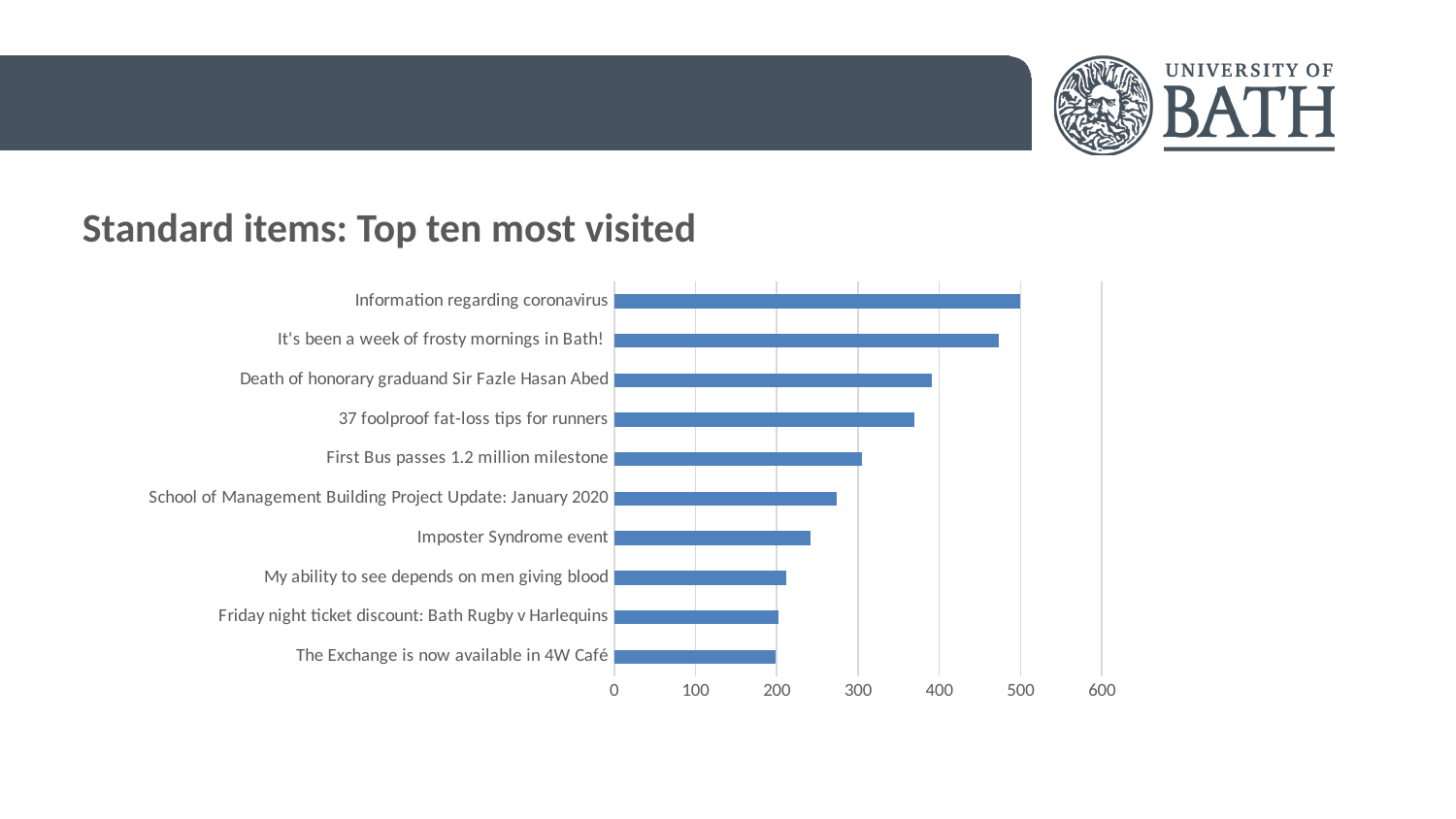
Which item has the highest value in the chart? Information regarding coronavirus Is the value for "37 foolproof fat-loss tips for runners" greater or less than 400? less What is the title of the slide above the chart? Standard items: Top ten most visited Is the value for "My ability to see depends on men giving blood" greater or less than 300? less Is the value for "Death of honorary graduand Sir Fazle Hasan Abed" greater or less than 300? greater Do the bar values increase or decrease going from the top item to the bottom item? decrease What kind of chart is shown on the slide? bar chart How many items are plotted in the chart? 10 Which has the larger value: "First Bus passes 1.2 million milestone" or "Imposter Syndrome event"? First Bus passes 1.2 million milestone